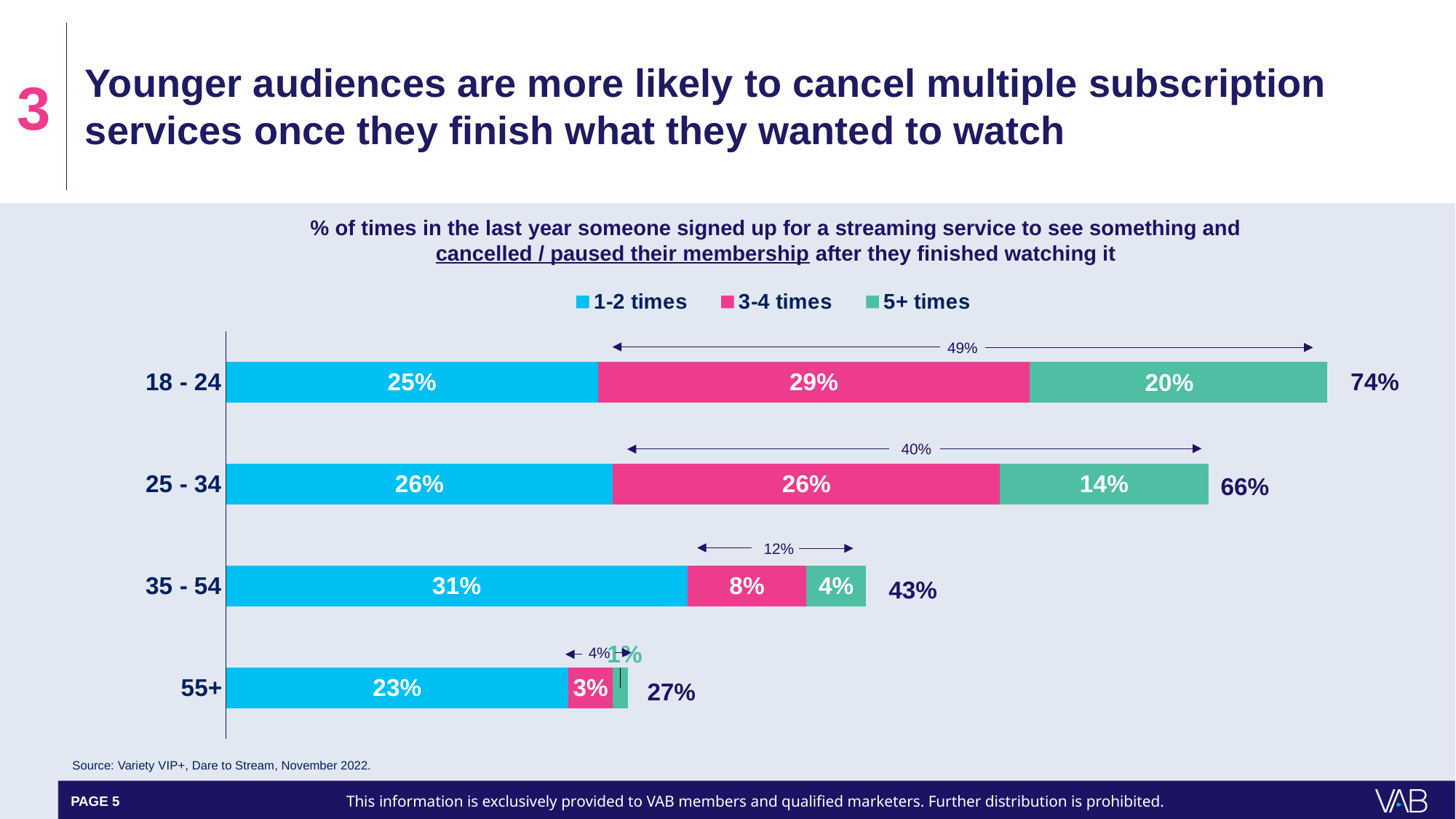
What is the difference between the 3-4 times values for 18 - 24 and 35 - 54? 21% Which age group has the lowest value for 3-4 times? 55+ How many series does the legend list? 3 Which is larger: the 1-2 times value for 35 - 54 or for 55+? 35 - 54 What kind of chart is shown on the slide? Stacked bar chart How many age groups are shown in the chart? 4 What is the value for 1-2 times in the 35 - 54 age group? 31% Which age group has the highest value for 5+ times? 18 - 24 What is the total shown for the 55+ age group? 27% What is the value for 3-4 times in the 18 - 24 age group? 29% What is the value for 5+ times in the 25 - 34 age group? 14% What is the total shown for the 18 - 24 age group? 74%